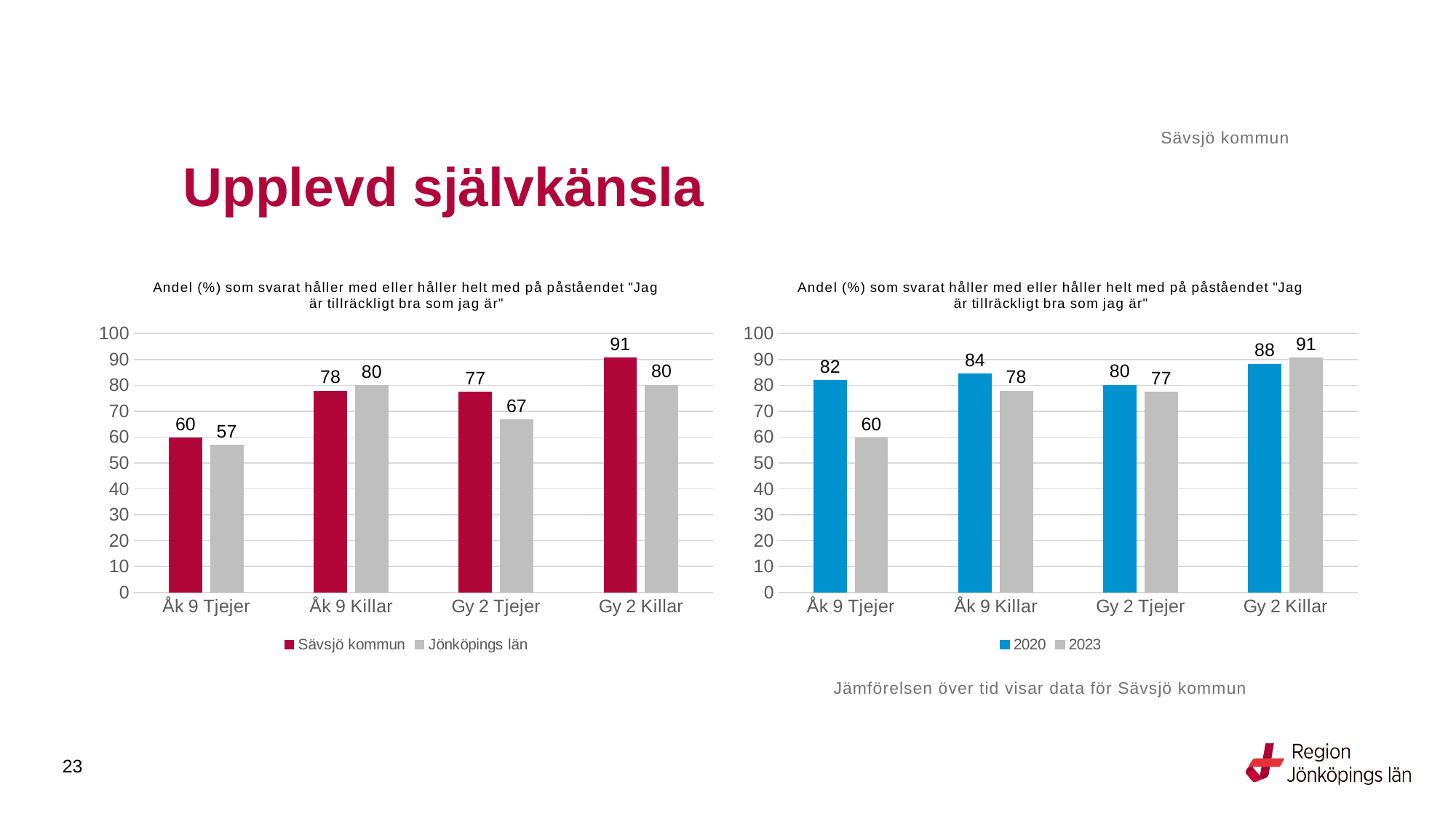
In the right chart, what is the difference between 2020 and 2023 for Åk 9 Tjejer? 22 In the right chart, which category has the highest value for 2023? Gy 2 Killar How many categories are shown on the x axis of the left chart? 4 What kind of chart is the right chart? Bar chart In the left chart, which is larger for Åk 9 Killar: Sävsjö kommun or Jönköpings län? Jönköpings län In the left chart, what is the value for Jönköpings län for Gy 2 Tjejer? 67 In the left chart, what is the value for Sävsjö kommun for Gy 2 Killar? 91 In the right chart, what is the value for 2023 for Gy 2 Tjejer? 77 In the right chart, what is the value for 2020 for Åk 9 Tjejer? 82 In the left chart, what is the difference between Sävsjö kommun and Jönköpings län for Gy 2 Killar? 11 In the left chart, which category has the lowest value for Jönköpings län? Åk 9 Tjejer In the right chart, how many series does the legend list? 2